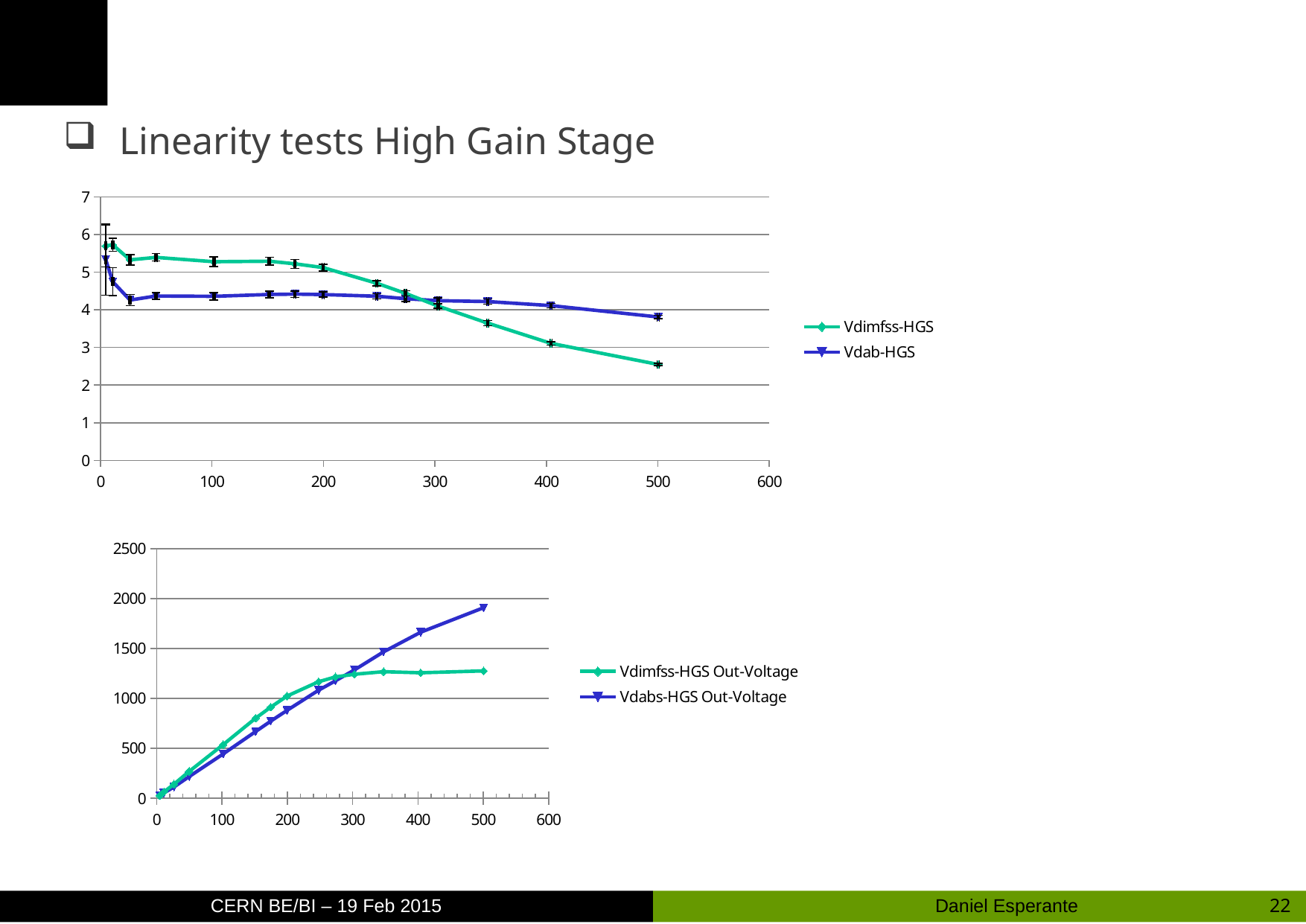
In the top chart, is the value of Vdimfss-HGS at x = 0 greater or less than 5? greater In the top chart, which series has the higher value at x = 500, Vdimfss-HGS or Vdab-HGS? Vdab-HGS In the bottom chart, is the value of Vdabs-HGS Out-Voltage at x = 500 greater or less than 1500? greater In the top chart, is the value of Vdimfss-HGS at x = 500 greater or less than 3? less How many series does the legend of the bottom chart list? 2 What kind of chart is the top chart on the slide? line chart In the bottom chart, which series has the higher value at x = 500, Vdimfss-HGS Out-Voltage or Vdabs-HGS Out-Voltage? Vdabs-HGS Out-Voltage How many series does the legend of the top chart list? 2 In the top chart, which series has the higher value at x = 100, Vdimfss-HGS or Vdab-HGS? Vdimfss-HGS In the bottom chart, does the Vdabs-HGS Out-Voltage series rise or fall as x increases from 0 to 500? rise In the top chart, does the Vdimfss-HGS series rise or fall as x increases from 100 to 500? fall